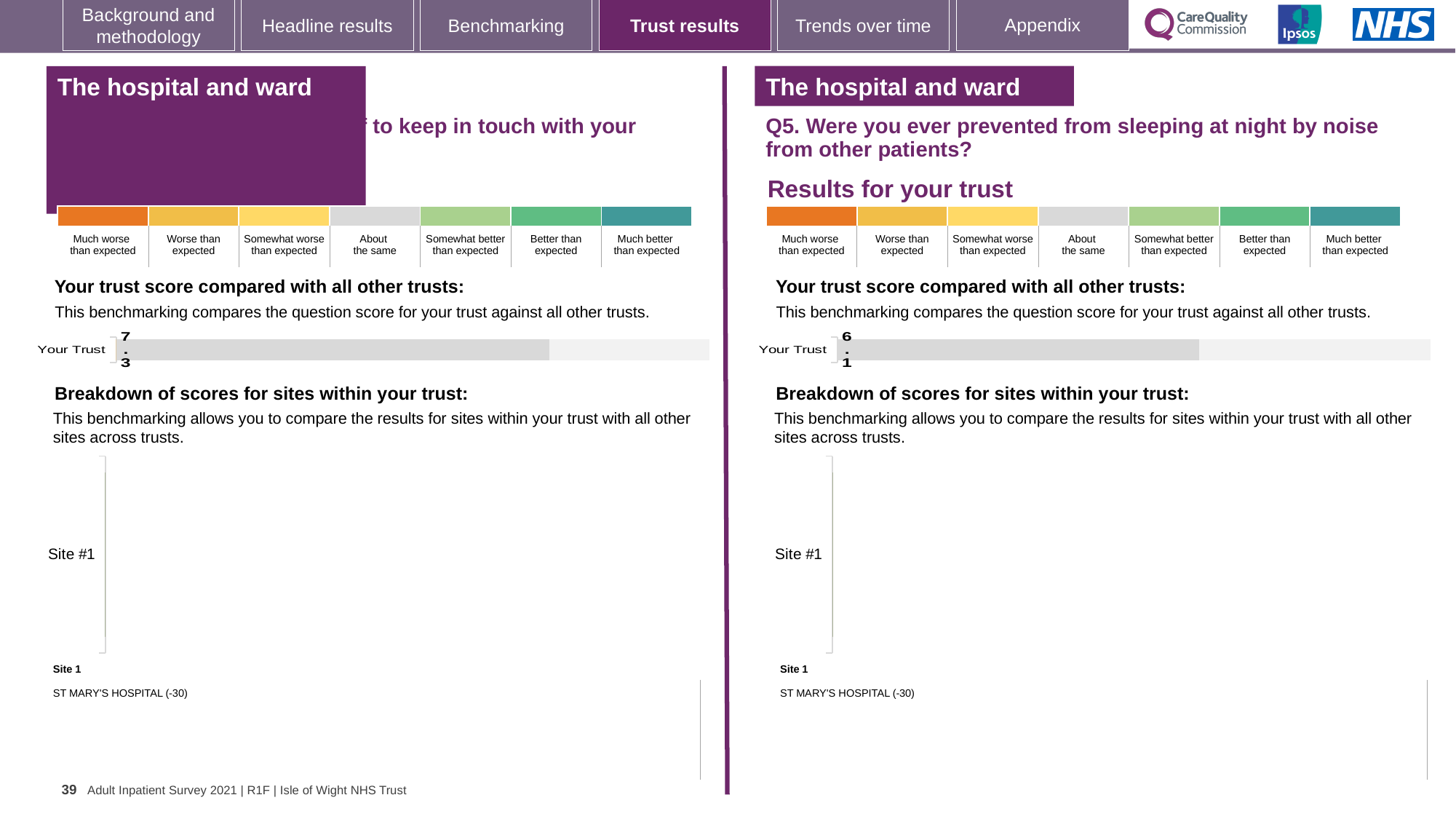
Is the Your Trust score on the right-hand Q5 panel greater or less than 7? less Is the Your Trust score on the left-hand panel greater or less than 7? greater Which panel shows the higher Your Trust score, the left-hand panel or the right-hand Q5 panel? The left-hand panel How many categories are plotted in the 'Your trust score compared with all other trusts' chart on the right-hand Q5 panel? 1 What site is listed as Site 1 in the breakdown of scores on the right-hand Q5 panel? ST MARY'S HOSPITAL (-30) On the right-hand panel (Q5, prevented from sleeping at night by noise from other patients), what is the score shown for Your Trust? 6.1 What kind of chart is used to show the Your Trust score on each panel? Bar chart How many colour bands are shown in the benchmarking key above the charts on the right-hand Q5 panel? 7 What is the difference between the Your Trust score on the left-hand panel and the Your Trust score on the right-hand Q5 panel? 1.2 On the left-hand panel, what is the score shown for Your Trust in the 'Your trust score compared with all other trusts' chart? 7.3 In the benchmarking key on the right-hand Q5 panel, what label is given to the grey band? About the same